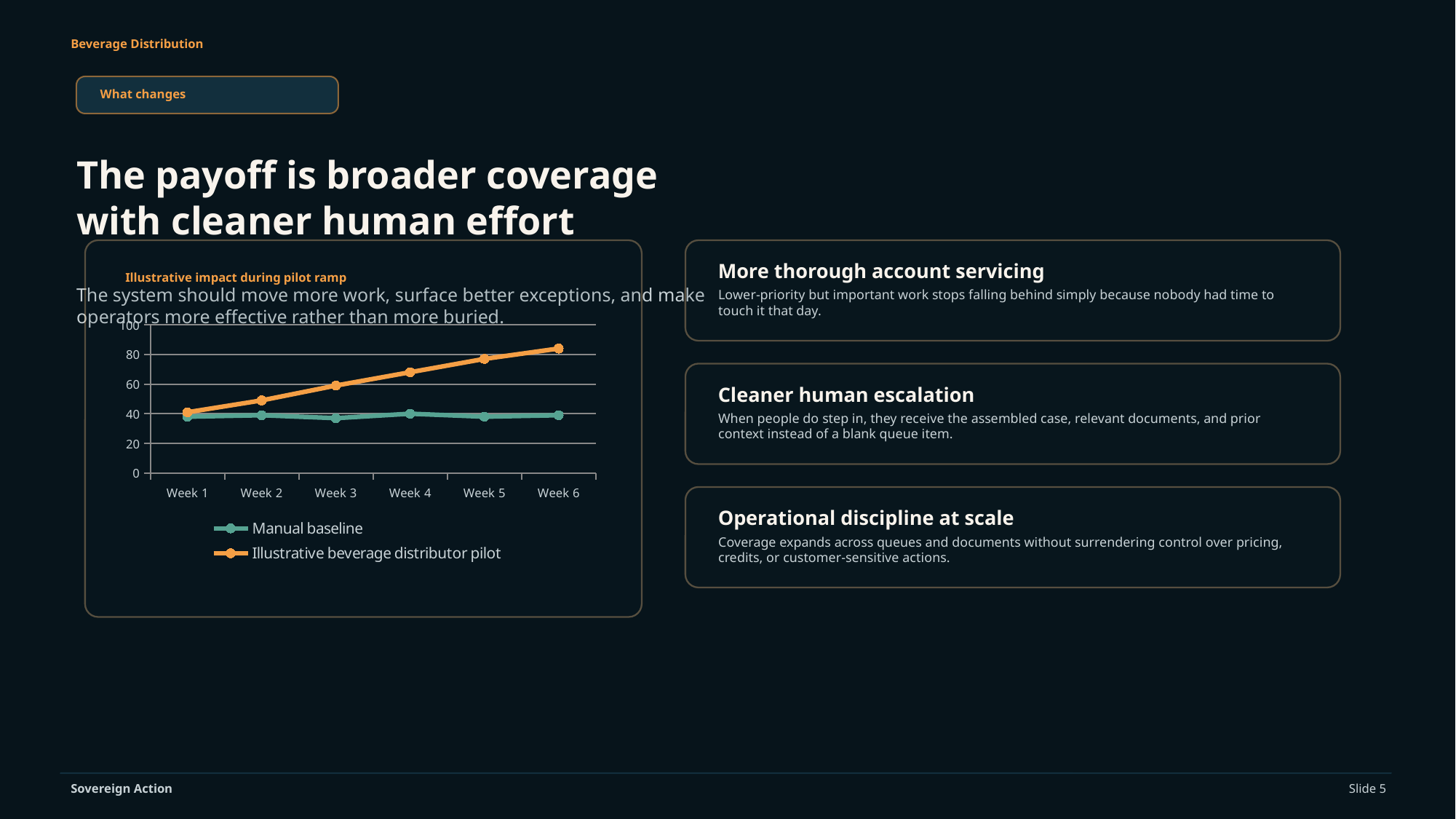
Is the value for the Illustrative beverage distributor pilot in Week 6 greater or less than 80? greater Does the Illustrative beverage distributor pilot series rise or fall from Week 1 to Week 6? Rise What is the title of the chart? Illustrative impact during pilot ramp In which week is the Illustrative beverage distributor pilot series at its lowest value? Week 1 In which week does the Illustrative beverage distributor pilot series reach its highest value? Week 6 Which two series are listed in the chart legend? Manual baseline; Illustrative beverage distributor pilot In Week 6, which series has the larger value: Manual baseline or Illustrative beverage distributor pilot? Illustrative beverage distributor pilot What kind of chart is shown on the slide? Line chart Is the value for the Manual baseline in Week 5 greater or less than 60? less How many weeks are plotted along the x axis of the chart? 6 Is the value for the Illustrative beverage distributor pilot in Week 2 greater or less than 60? less How many series does the chart legend list? 2